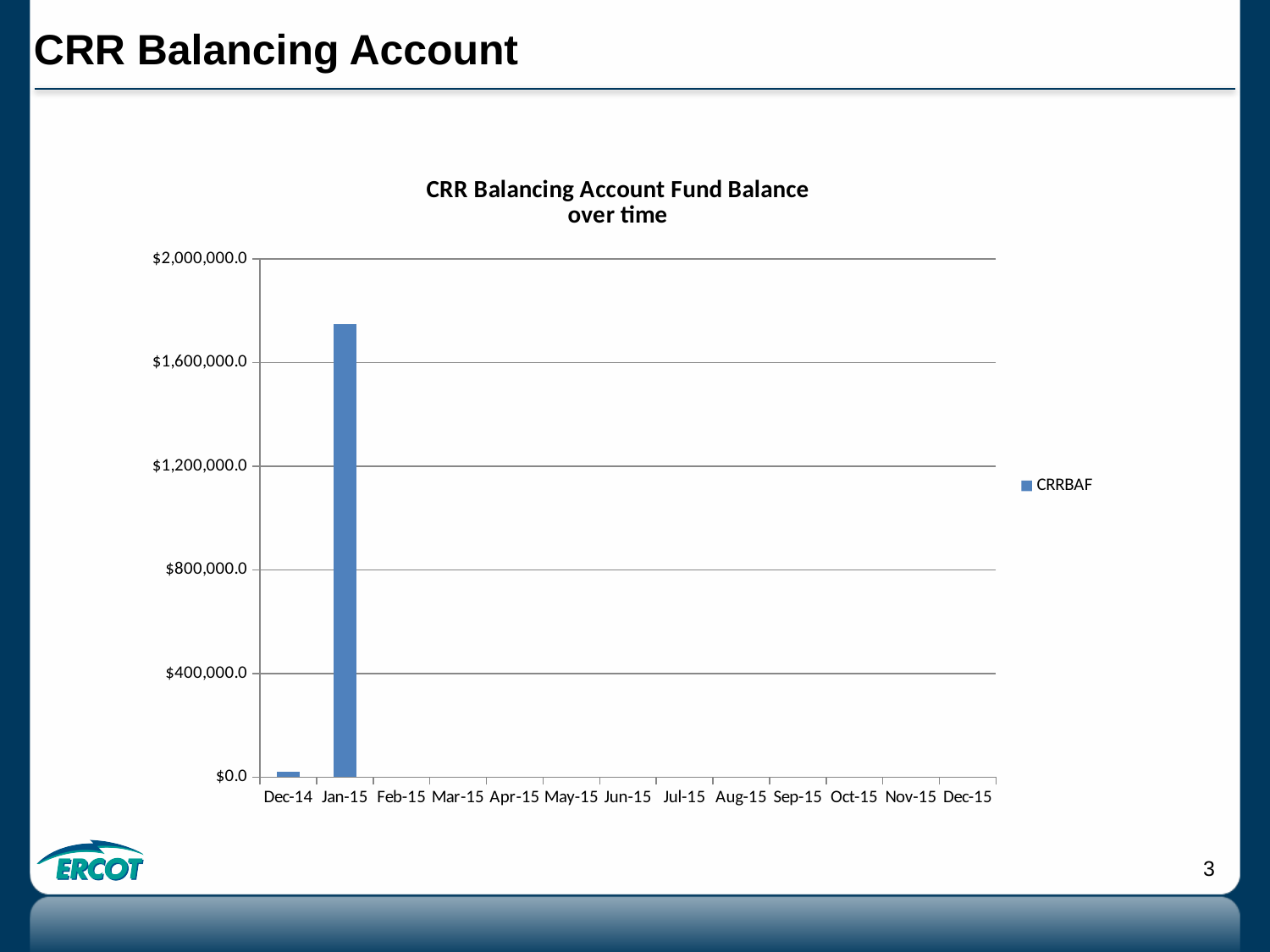
How many series does the legend list? 1 What is the name of the series shown in the legend? CRRBAF What is the title of the chart? CRR Balancing Account Fund Balance over time Is the value for Dec-14 greater or less than $400,000.0? less How many months are shown on the x axis? 13 Does the CRRBAF balance rise or fall from Dec-14 to Jan-15? rise Which month has the highest CRRBAF balance? Jan-15 Which is larger, the value for Dec-14 or the value for Jan-15? Jan-15 Is the value for Jan-15 greater or less than $1,600,000.0? greater What kind of chart is shown on the slide? bar chart Is the value for Jan-15 greater or less than $2,000,000.0? less